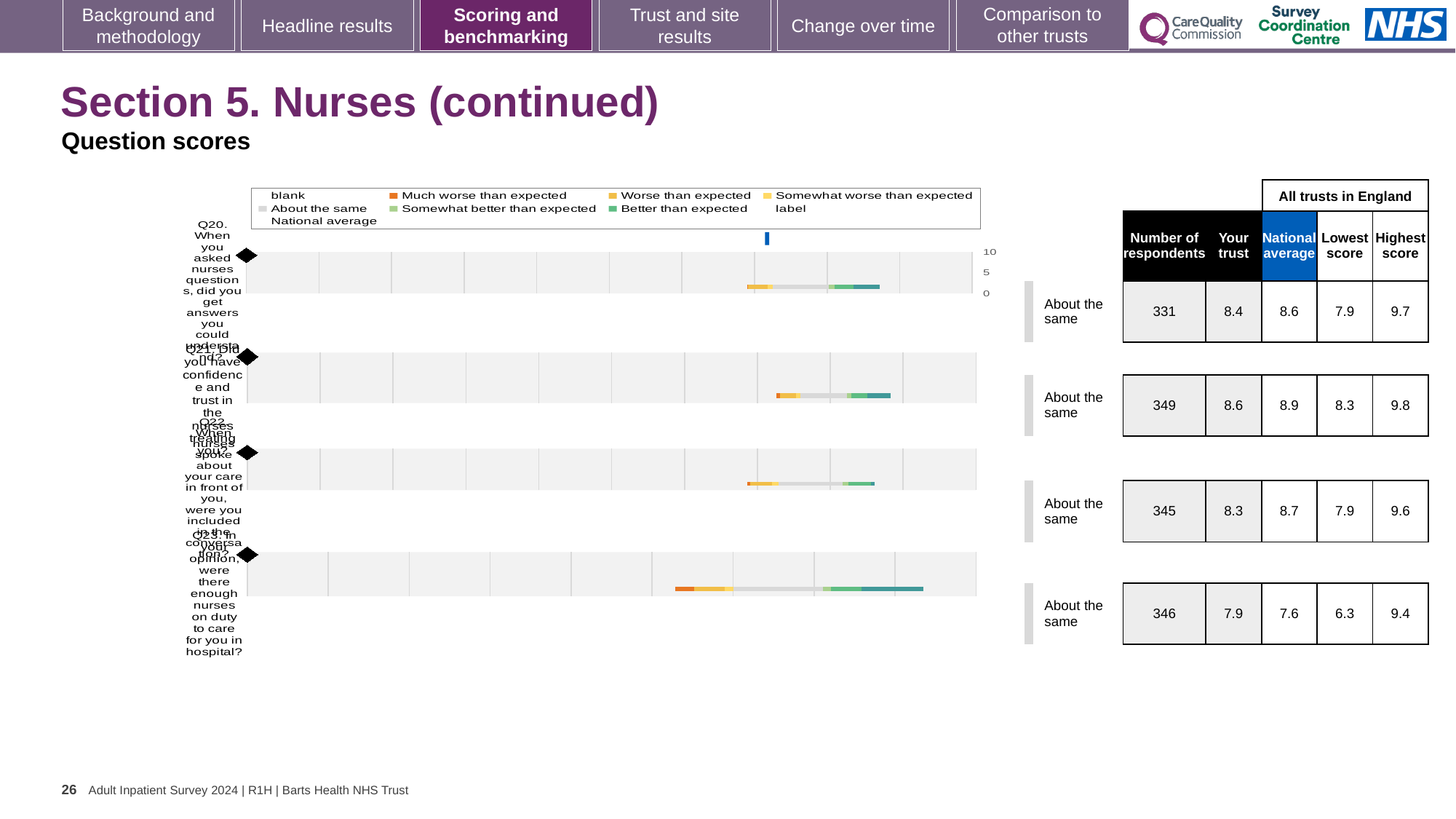
For Q23, which is larger in the table: the 'Your trust' score or the national average? Your trust For Q23, what is the difference between the 'Your trust' score and the national average shown in the table? 0.3 Which question has the lowest 'Your trust' score in the table next to the chart? Q23 How many questions (categories) are plotted in the chart? 4 What kind of chart is used to show the question scores for Q20 to Q23? bar chart What colour does the legend use for 'Much worse than expected'? orange According to the table next to the chart, how many respondents answered Q22? 345 Which question has the highest 'Your trust' score in the table next to the chart? Q21 What benchmark category is shown beside the chart for Q22? About the same According to the table next to the chart, what is the national average for Q21? 8.9 According to the table next to the chart, what is the 'Your trust' score for Q20? 8.4 According to the table next to the chart, what is the lowest score among all trusts in England for Q23? 6.3